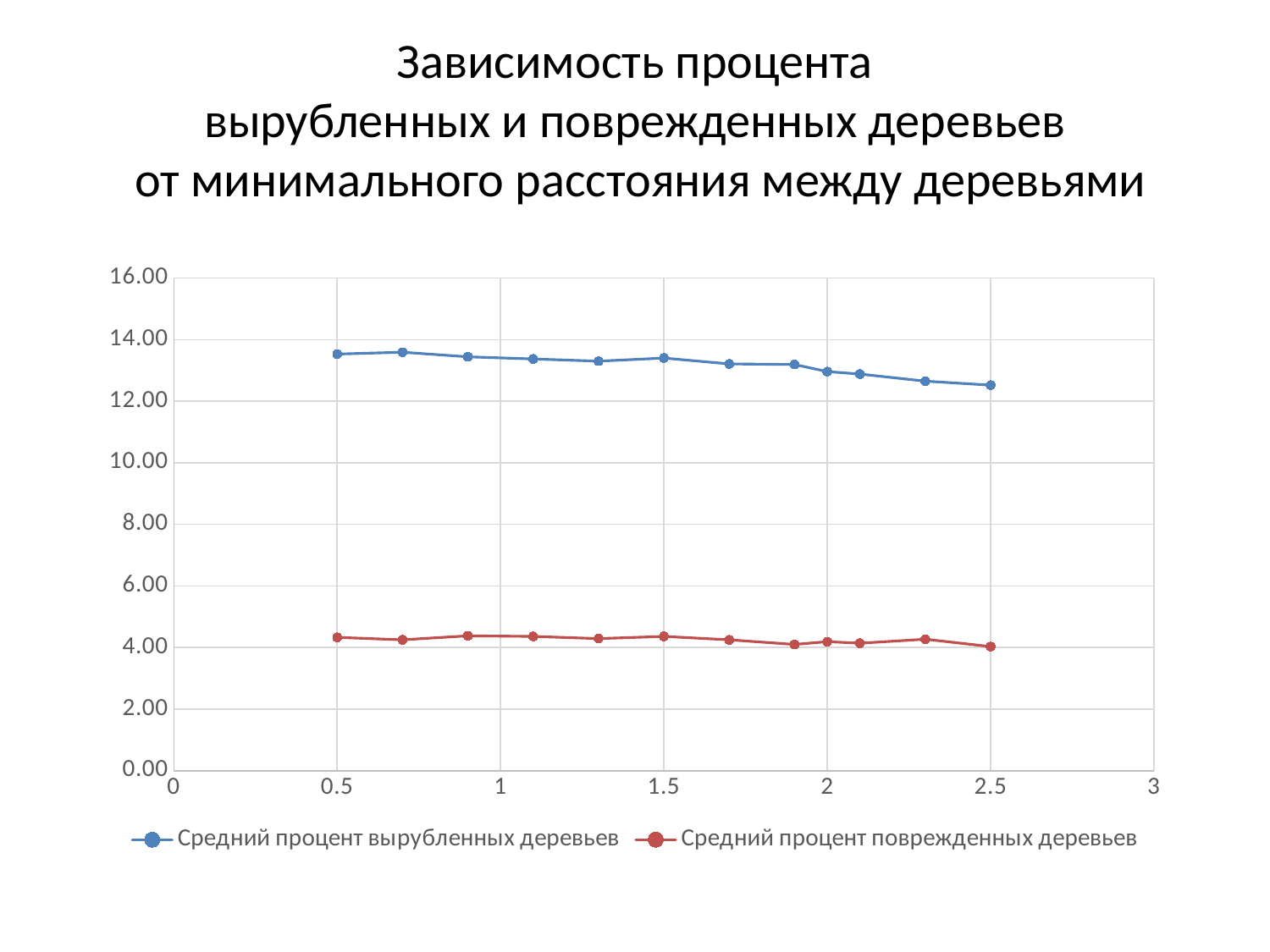
Is the value of "Средний процент поврежденных деревьев" at x = 2.5 greater or less than 6.00? less Is the value of "Средний процент вырубленных деревьев" at x = 2.5 greater or less than 14.00? less How many data points does the series "Средний процент вырубленных деревьев" have? 12 What kind of chart is shown on the slide? line chart At which x value does "Средний процент вырубленных деревьев" reach its lowest point? 2.5 Is the value of "Средний процент поврежденных деревьев" at x = 1.5 greater or less than 4.00? greater Which series is drawn in red? Средний процент поврежденных деревьев What is the maximum value shown on the vertical axis? 16.00 Do the values of "Средний процент вырубленных деревьев" generally rise or fall as x increases? fall At x = 1.5, which series has the larger value: "Средний процент вырубленных деревьев" or "Средний процент поврежденных деревьев"? Средний процент вырубленных деревьев How many series does the legend list? 2